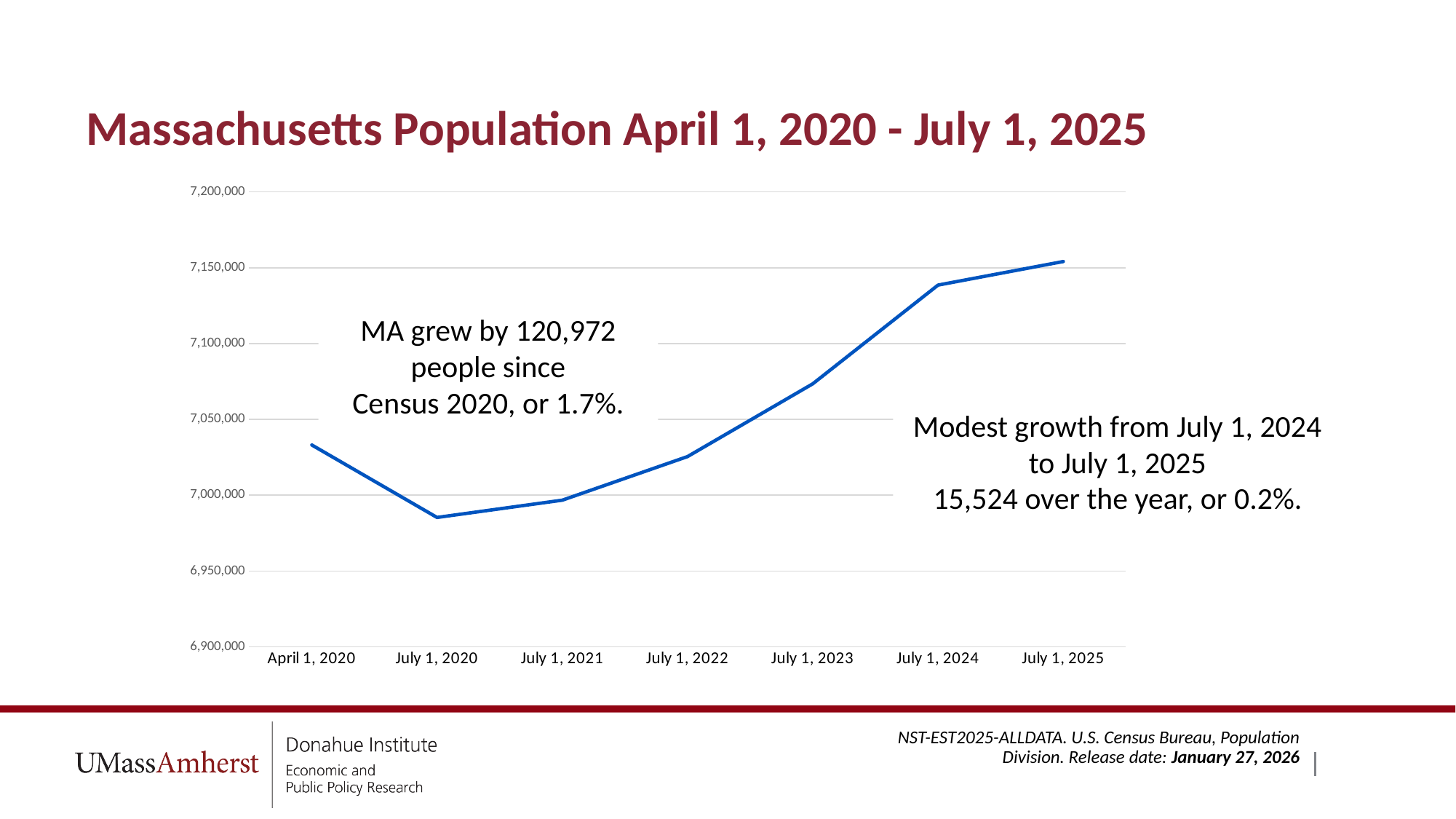
Does the population rise or fall from July 1, 2020 to July 1, 2025? rise Which is larger, the population on April 1, 2020 or on July 1, 2020? April 1, 2020 Is the value for April 1, 2020 greater or less than 7,000,000? greater How many dates are plotted along the x axis of the chart? 7 What kind of chart is shown on the slide? line chart At which date is the Massachusetts population lowest on the chart? July 1, 2020 According to the annotation on the chart, by how many people did MA grow since Census 2020? 120,972 Is the value for July 1, 2024 greater or less than 7,100,000? greater Is the value for July 1, 2023 greater or less than 7,100,000? less What is the title of the chart? Massachusetts Population April 1, 2020 - July 1, 2025 At which date is the Massachusetts population highest on the chart? July 1, 2025